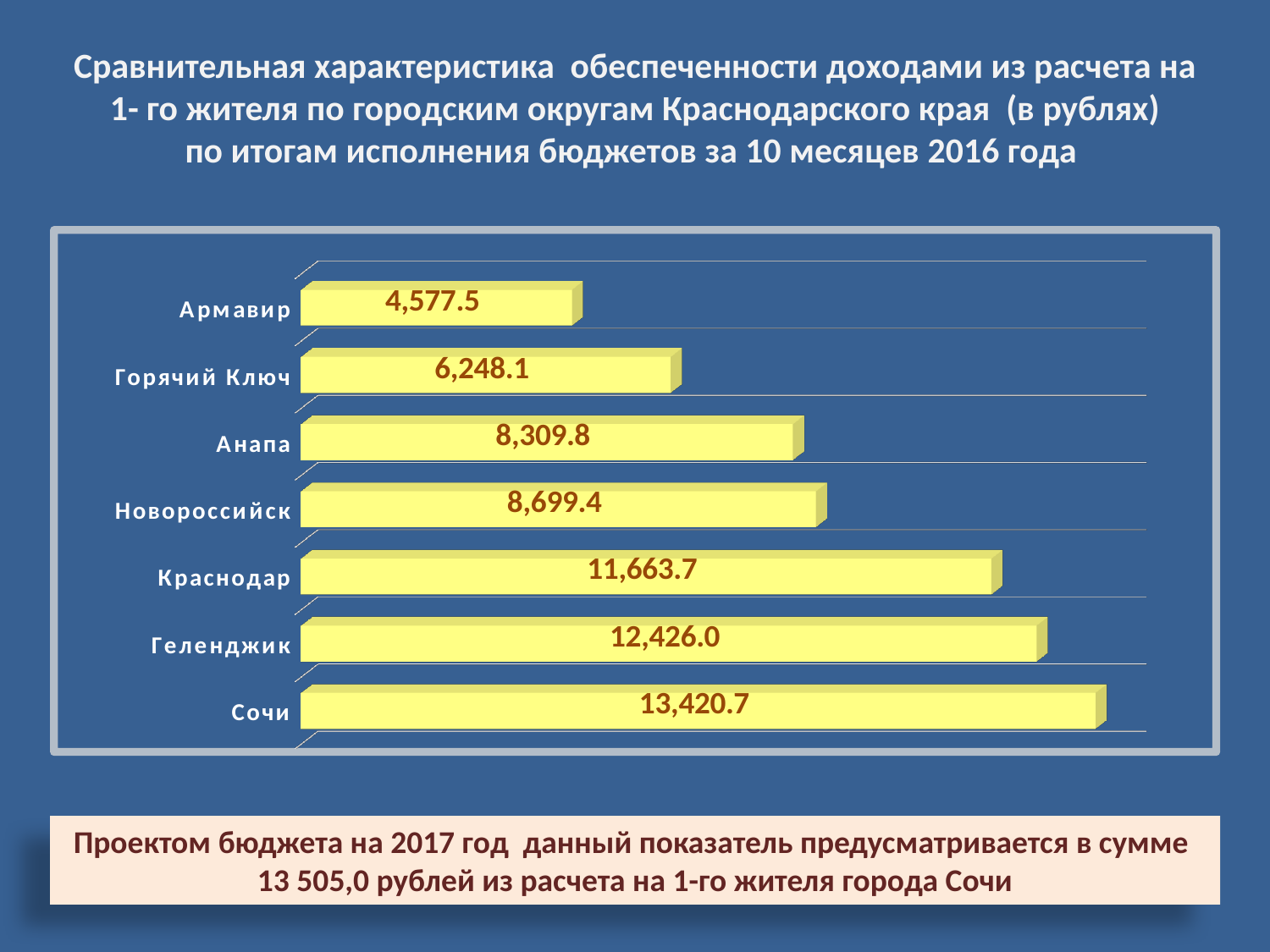
Do the values rise or fall going down the chart from Армавир to Сочи? Rise What kind of chart is shown on the slide? Bar chart Which city has the lowest value on the chart? Армавир What is the value shown for Новороссийск? 8,699.4 What colour are the bars on the chart? Yellow What is the value shown for Горячий Ключ? 6,248.1 Which city has the highest value on the chart? Сочи What is the difference between the values for Новороссийск and Анапа? 389.6 How many cities are shown on the chart? 7 What is the value shown for Сочи? 13,420.7 What is the difference between the values for Сочи and Геленджик? 994.7 Which has a larger value, Краснодар or Анапа? Краснодар